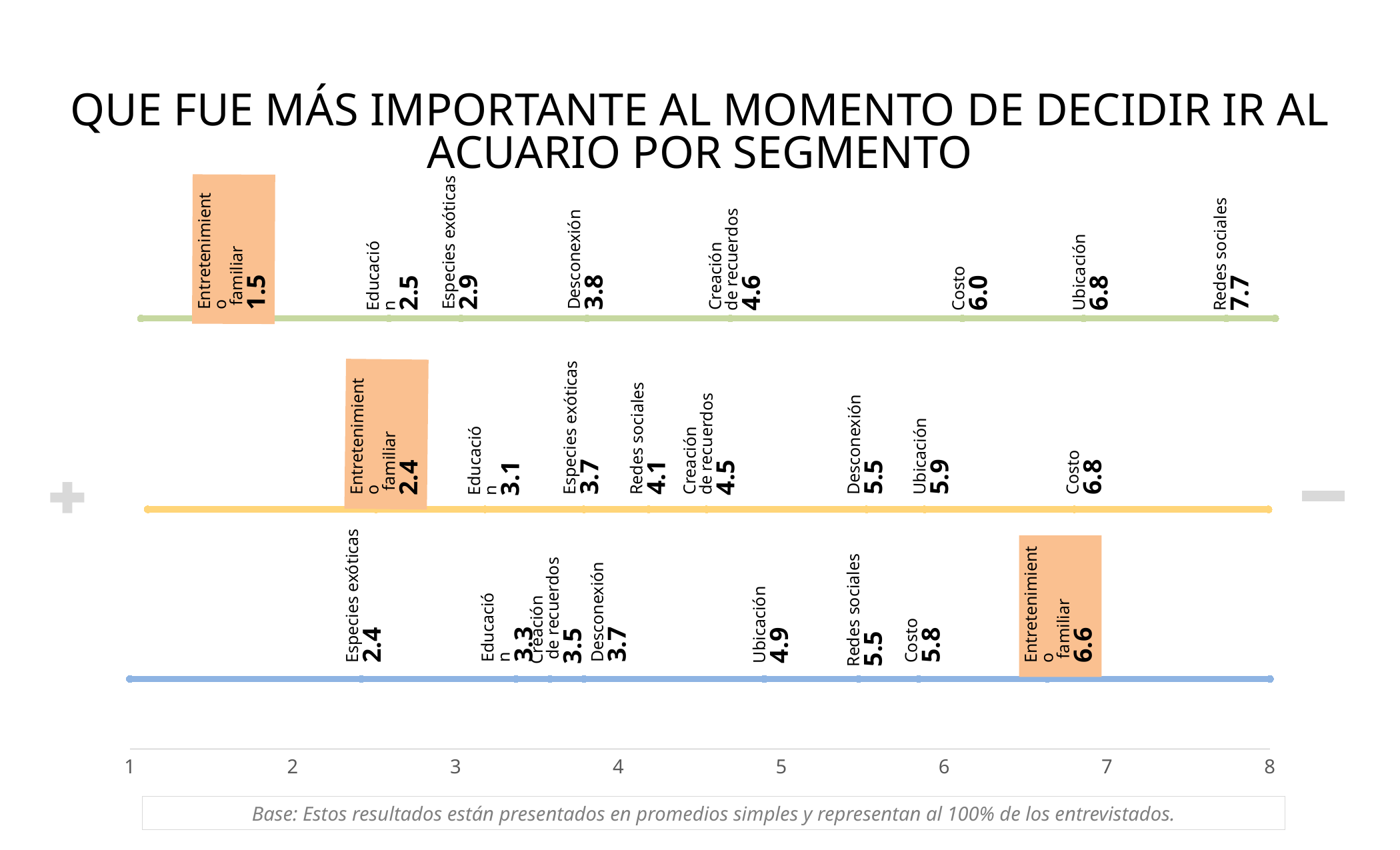
On the top (green) line, what is the value for Redes sociales? 7.7 What is the value for Ubicación on the top (green) line? 6.8 On the middle (yellow) line, which category has the lowest value? Entretenimiento familiar On the bottom (blue) line, what is the difference between the values for Costo and Especies exóticas? 3.4 On the middle (yellow) line, what is the value for Costo? 6.8 On the middle (yellow) line, which is larger: the value for Desconexión or the value for Redes sociales? Desconexión How many categories are plotted on the top (green) line? 8 On the bottom (blue) line, which category has the highest value? Entretenimiento familiar On the bottom (blue) line, what is the value for Entretenimiento familiar? 6.6 On the top (green) line, which category has the lowest value? Entretenimiento familiar On the top (green) line, what is the difference between the values for Redes sociales and Entretenimiento familiar? 6.2 How many horizontal lines (segments) are plotted on the chart? 3